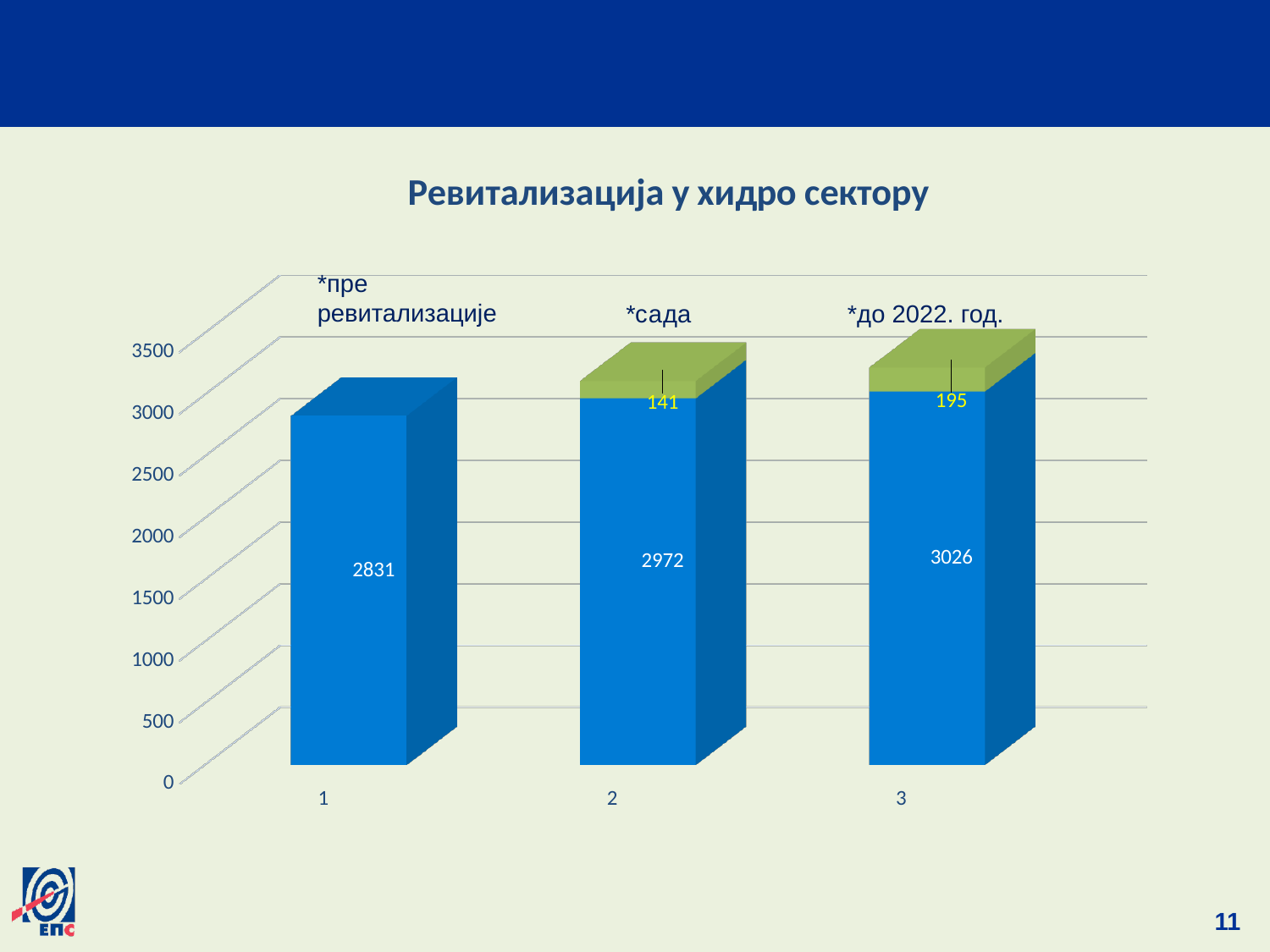
What is the value of the blue segment for category 3? 3026 Which category has the lowest blue segment value? 1 Which category has the highest blue segment value? 3 What is the title of the chart? Ревитализација у хидро сектору What is the value of the blue segment for category 2? 2972 What is the total of the stacked bar for category 2? 3113 How many categories are shown on the x axis of the chart? 3 What is the difference between the blue segment values for category 3 and category 1? 195 What is the value of the green segment for category 3? 195 What type of chart is shown on the slide? bar chart What is the value of the green segment for category 2? 141 What is the value of the blue segment for category 1? 2831